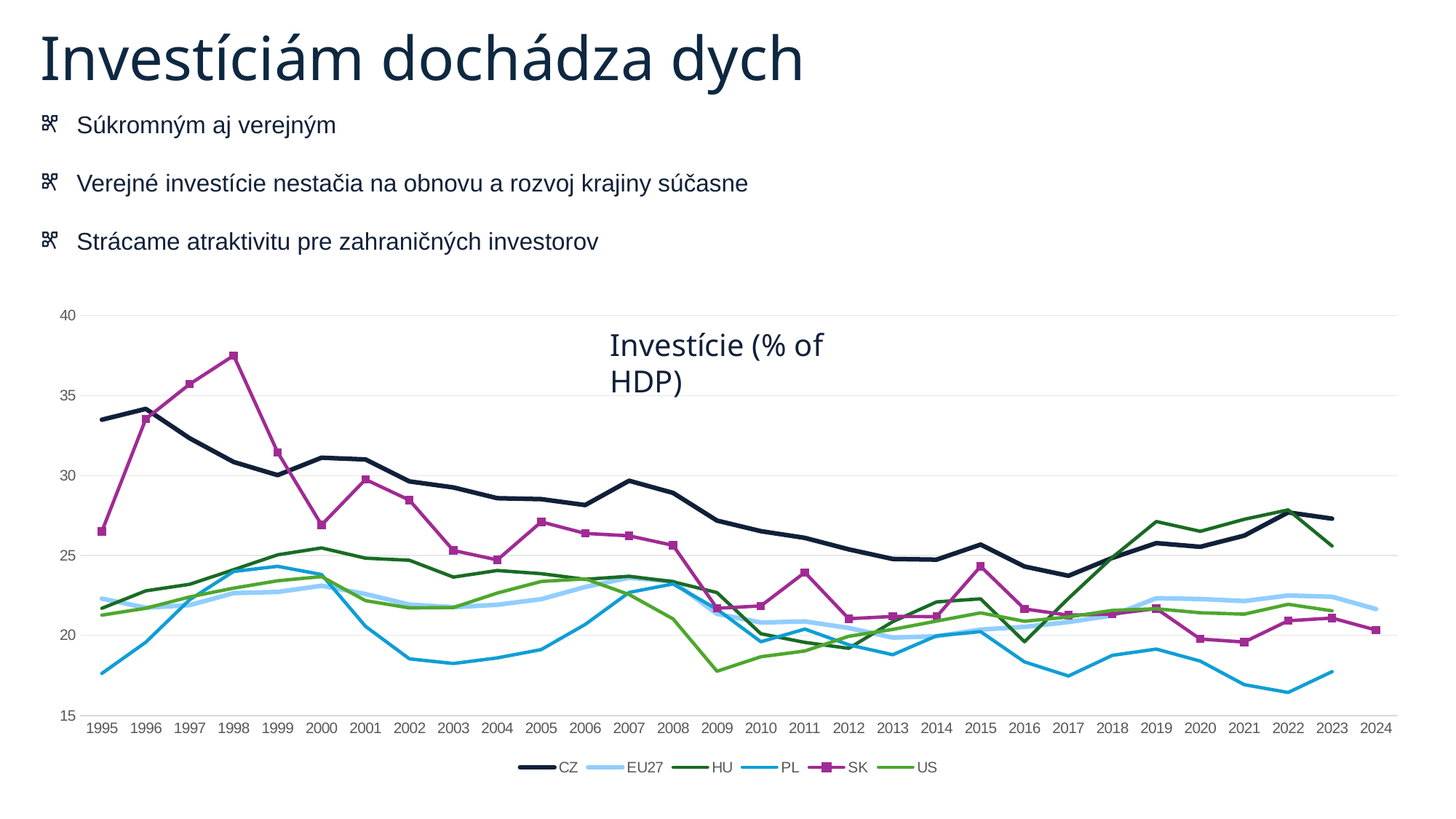
Which series has the lowest value in 1995? PL Is the value for PL in 1995 greater or less than 20? less How many series does the chart legend list? 6 Which series has the highest value in 1998? SK What is the title of the chart? Investície (% of HDP) Is the value for HU in 2022 greater or less than 25? greater Which series in the chart is drawn with square markers? SK Is the value for SK in 1998 greater or less than 35? greater How many years are shown on the x axis of the chart? 30 What kind of chart is shown on the slide? line chart In which year does the SK series reach its highest value? 1998